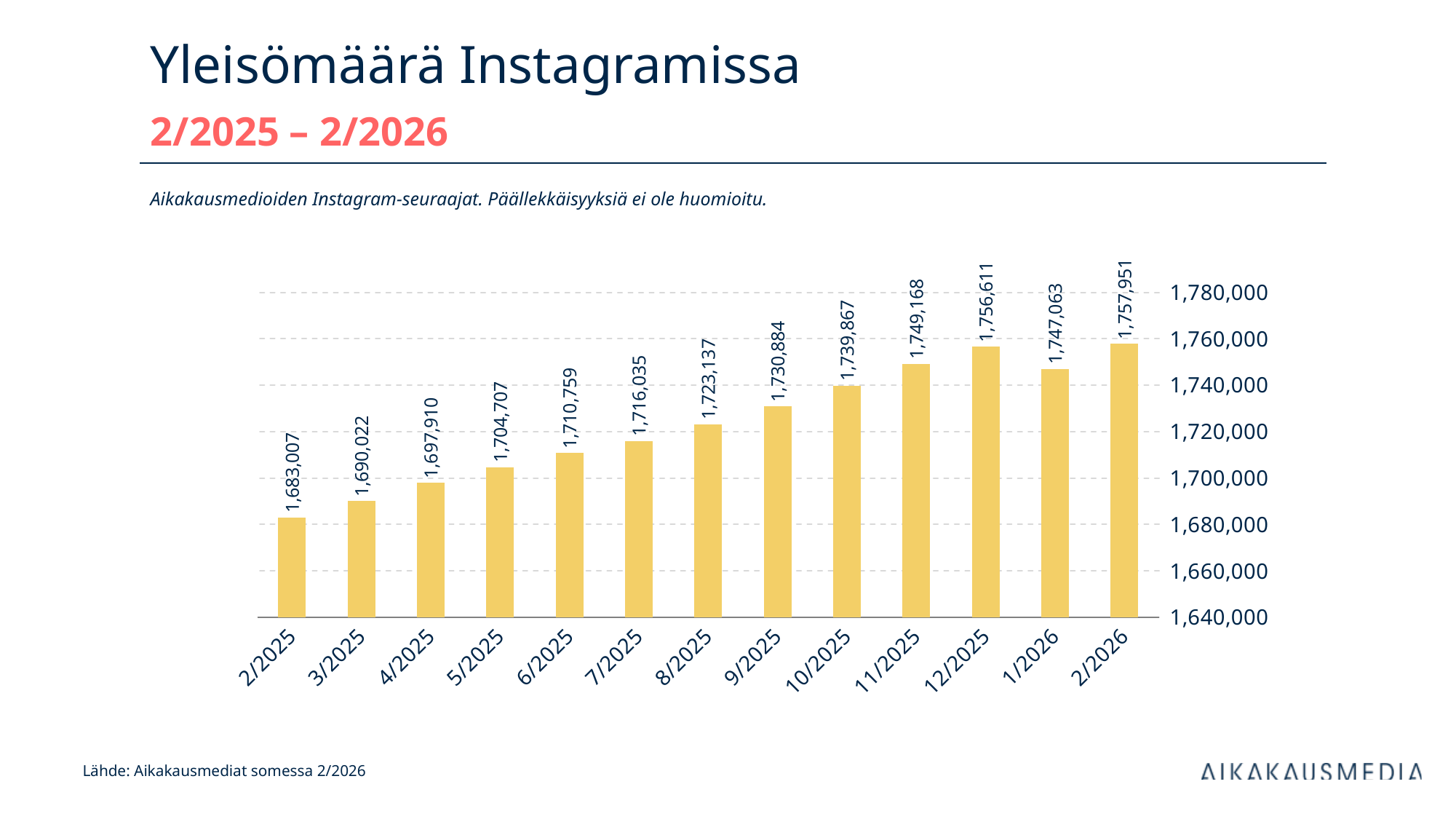
What is the value for 2/2025? 1,683,007 What is the value for 10/2025? 1,739,867 What kind of chart is shown on the slide? bar chart How many months are shown on the x axis? 13 Is the value for 6/2025 greater or less than 1,700,000? greater What is the title of the chart on the slide? Yleisömäärä Instagramissa What is the value for 1/2026? 1,747,063 Which month has the lowest value? 2/2025 What is the difference between the values for 2/2026 and 2/2025? 74,944 What is the difference between the values for 12/2025 and 1/2026? 9,548 Which month has the highest value? 2/2026 Which is larger, the value for 12/2025 or the value for 1/2026? 12/2025